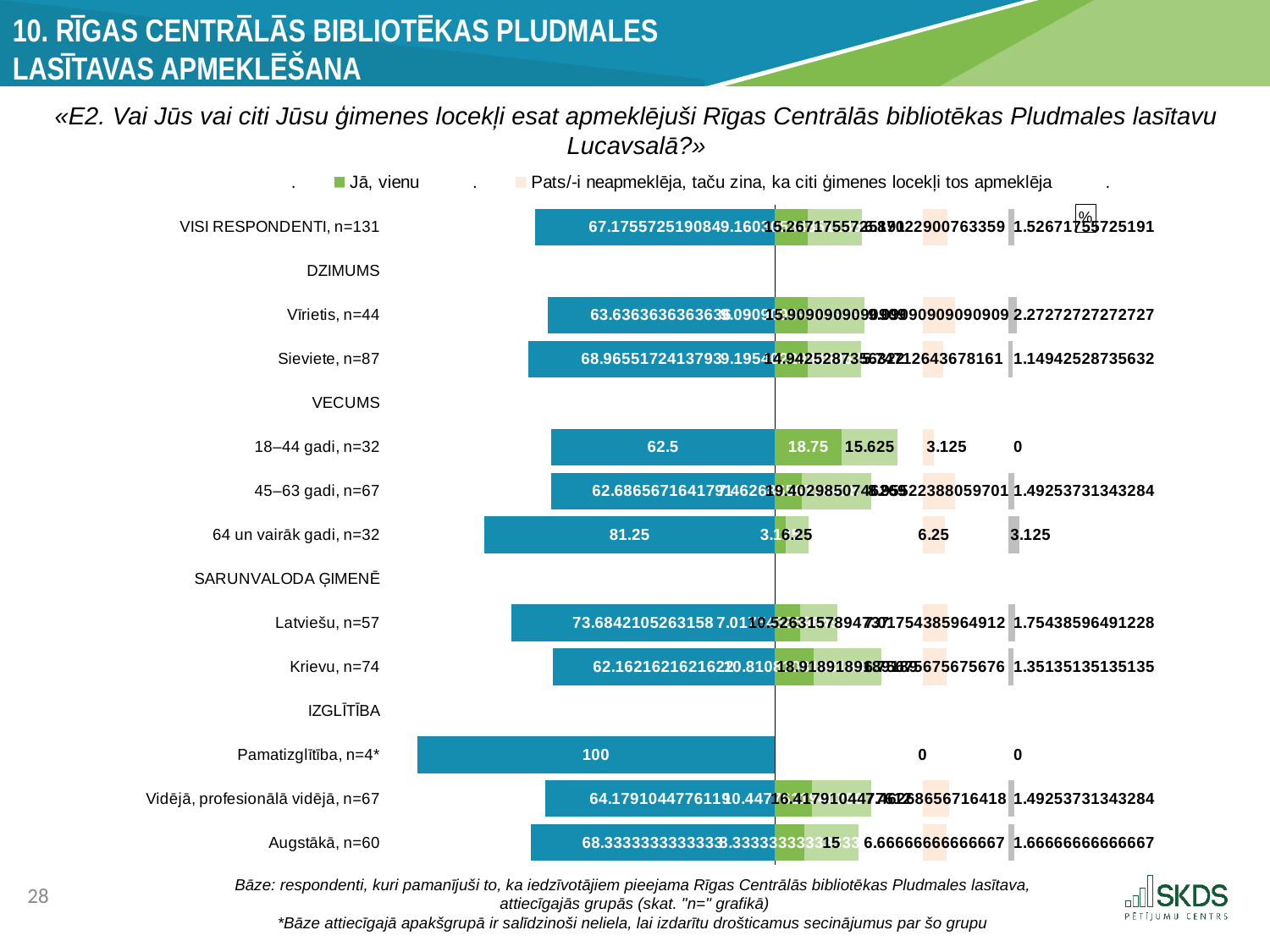
What is the value of the 'Pats/-i neapmeklēja, taču zina, ka citi ģimenes locekļi tos apmeklēja' segment for '64 un vairāk gadi, n=32'? 6.25 What is the value of the first (blue) segment for 'Pamatizglītība, n=4*'? 100 Which legend entry is shown with the light peach colour? Pats/-i neapmeklēja, taču zina, ka citi ģimenes locekļi tos apmeklēja What is the difference between the first (blue) segment values for '64 un vairāk gadi, n=32' and '18–44 gadi, n=32'? 18.75 What kind of chart is shown on the slide? bar chart What is the value of the first (blue) segment for '64 un vairāk gadi, n=32'? 81.25 How many bars (respondent groups) are plotted in the chart? 11 What is the value of the first (blue) segment for '18–44 gadi, n=32'? 62.5 What is the value of the 'Pats/-i neapmeklēja, taču zina, ka citi ģimenes locekļi tos apmeklēja' segment for '18–44 gadi, n=32'? 3.125 Which has a larger first (blue) segment: '64 un vairāk gadi, n=32' or '18–44 gadi, n=32'? 64 un vairāk gadi, n=32 What is the value of the last (grey) segment for '18–44 gadi, n=32'? 0 Which category has the largest first (blue) segment? Pamatizglītība, n=4*